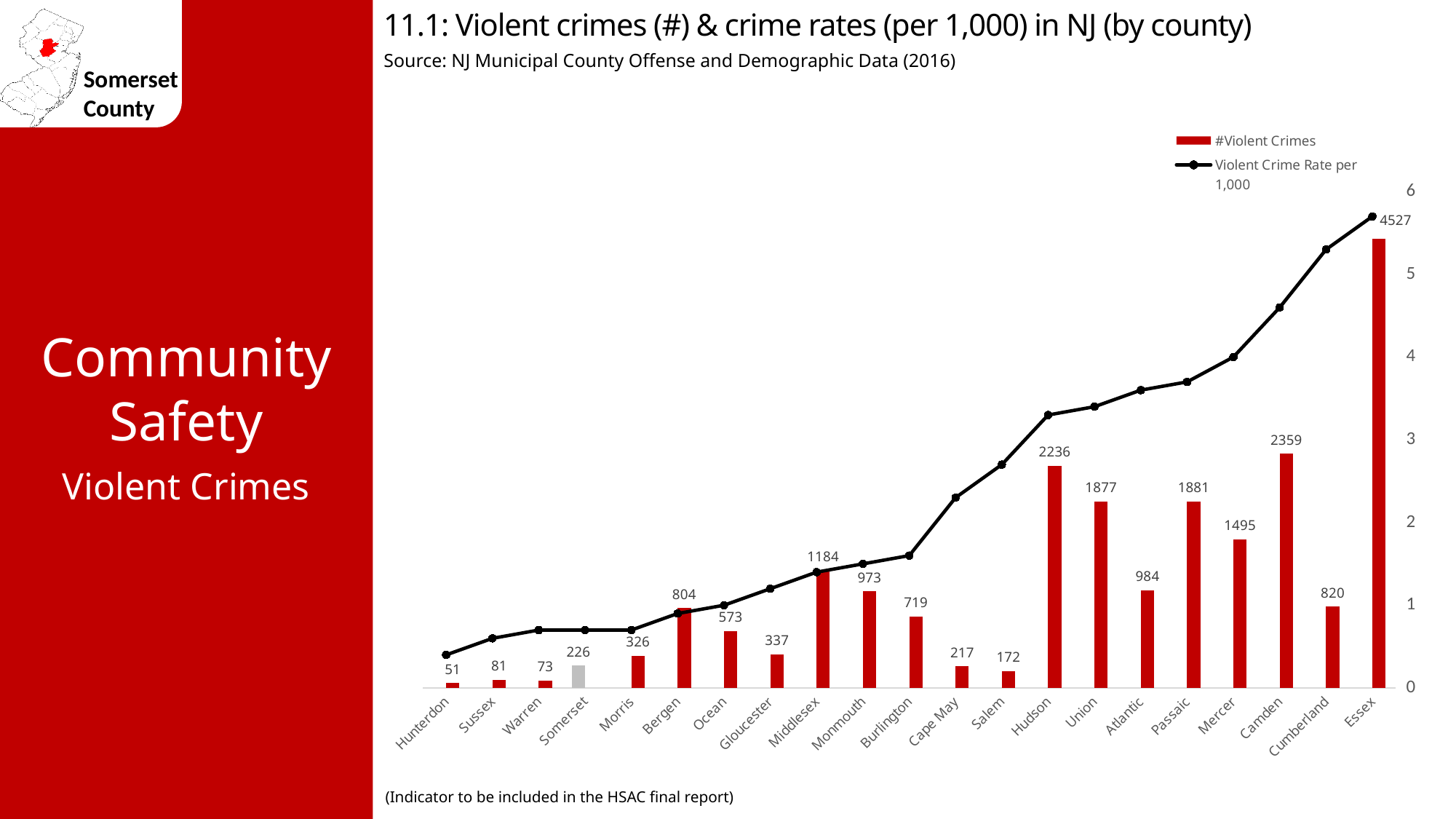
Is the violent crime rate per 1,000 for Hunterdon greater or less than 1? less What is the source cited for the chart data? NJ Municipal County Offense and Demographic Data (2016) What is the number of violent crimes for Hudson County? 2236 Which county has the lowest number of violent crimes? Hunterdon Does the violent crime rate per 1,000 line generally rise or fall from Hunterdon to Essex? rise How many violent crimes are shown for Somerset County? 226 How many counties are shown on the x axis of the chart? 21 Which county has more violent crimes, Passaic or Mercer? Passaic What is the difference in the number of violent crimes between Camden and Union? 482 Which county has the highest number of violent crimes? Essex How many series does the chart legend list? 2 Is the violent crime rate per 1,000 for Essex greater or less than 5? greater